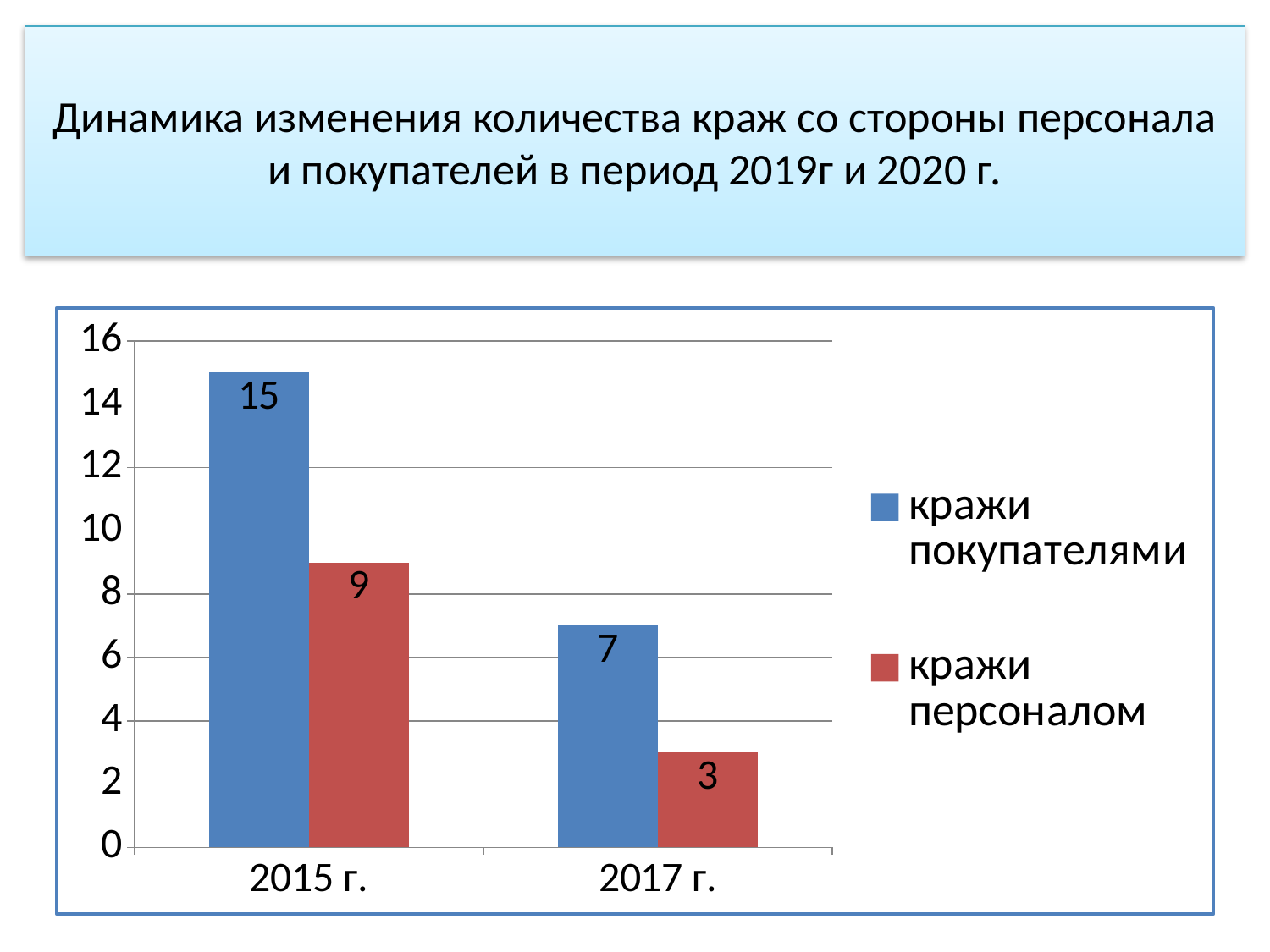
By how much did кражи покупателями decrease from 2015 г. to 2017 г.? 8 What is the difference between кражи покупателями and кражи персоналом in 2015 г.? 6 Do the values for кражи персоналом rise or fall from 2015 г. to 2017 г.? fall What is the value for кражи персоналом in 2015 г.? 9 What kind of chart is shown on the slide? bar chart Which year has the highest value for кражи покупателями? 2015 г. Which is larger in 2017 г.: кражи покупателями or кражи персоналом? кражи покупателями Which year has the lowest value for кражи персоналом? 2017 г. What is the value for кражи покупателями in 2015 г.? 15 What is the value for кражи персоналом in 2017 г.? 3 How many series does the legend list? 2 What is the value for кражи покупателями in 2017 г.? 7